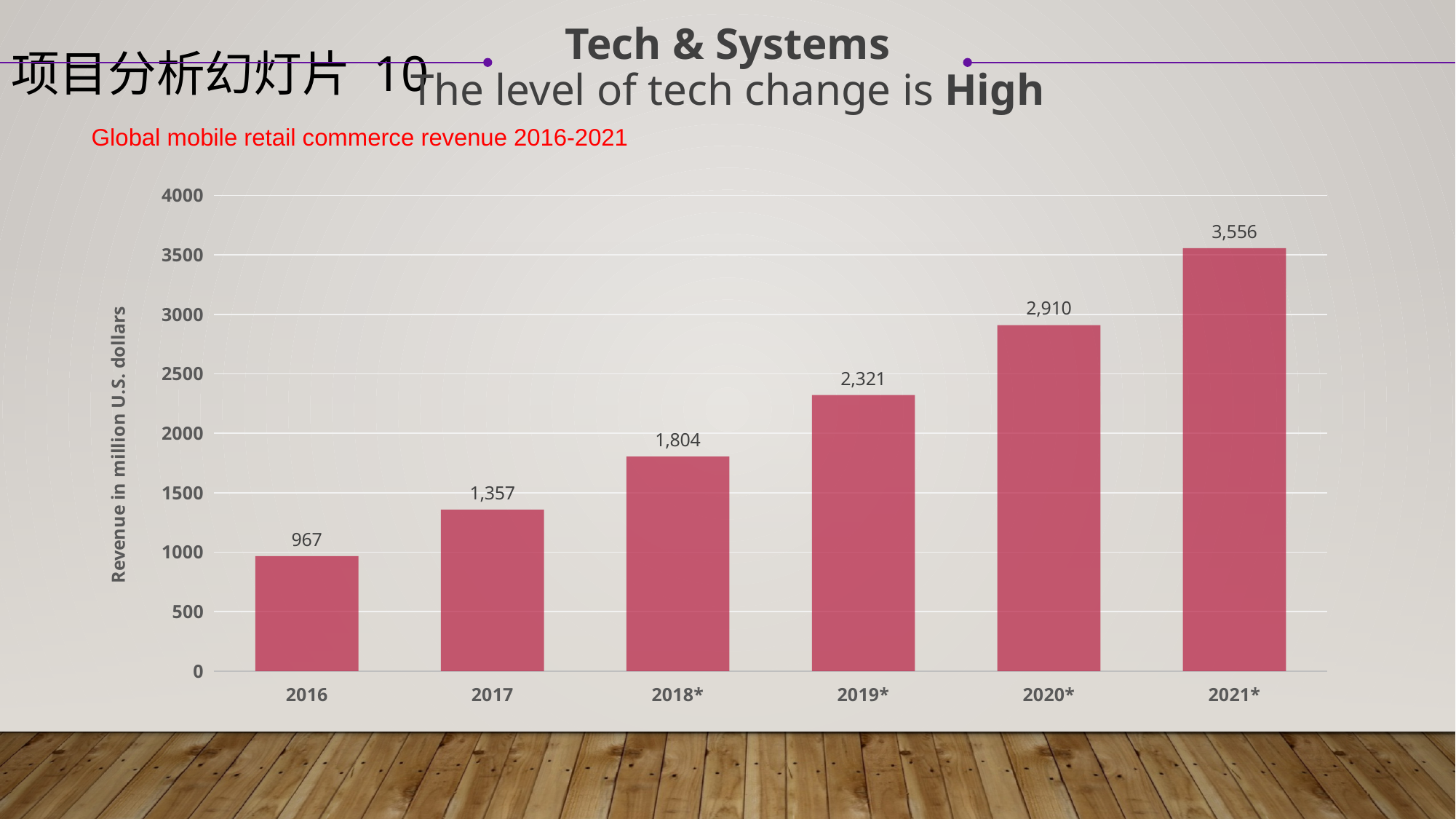
Which year has the highest revenue? 2021* What is the revenue value shown for 2021*? 3,556 What is the difference between the revenue for 2020* and 2019*? 589 What is the revenue value shown for 2016? 967 How many years are shown on the x axis? 6 Which is larger, the revenue for 2018* or 2017? 2018* Which year has the lowest revenue? 2016 What kind of chart is shown on the slide? bar chart Is the value for 2020* greater or less than 3000? less What is the revenue value shown for 2019*? 2,321 What is the difference between the revenue for 2017 and 2016? 390 Do the revenue values rise or fall from 2016 to 2021*? rise